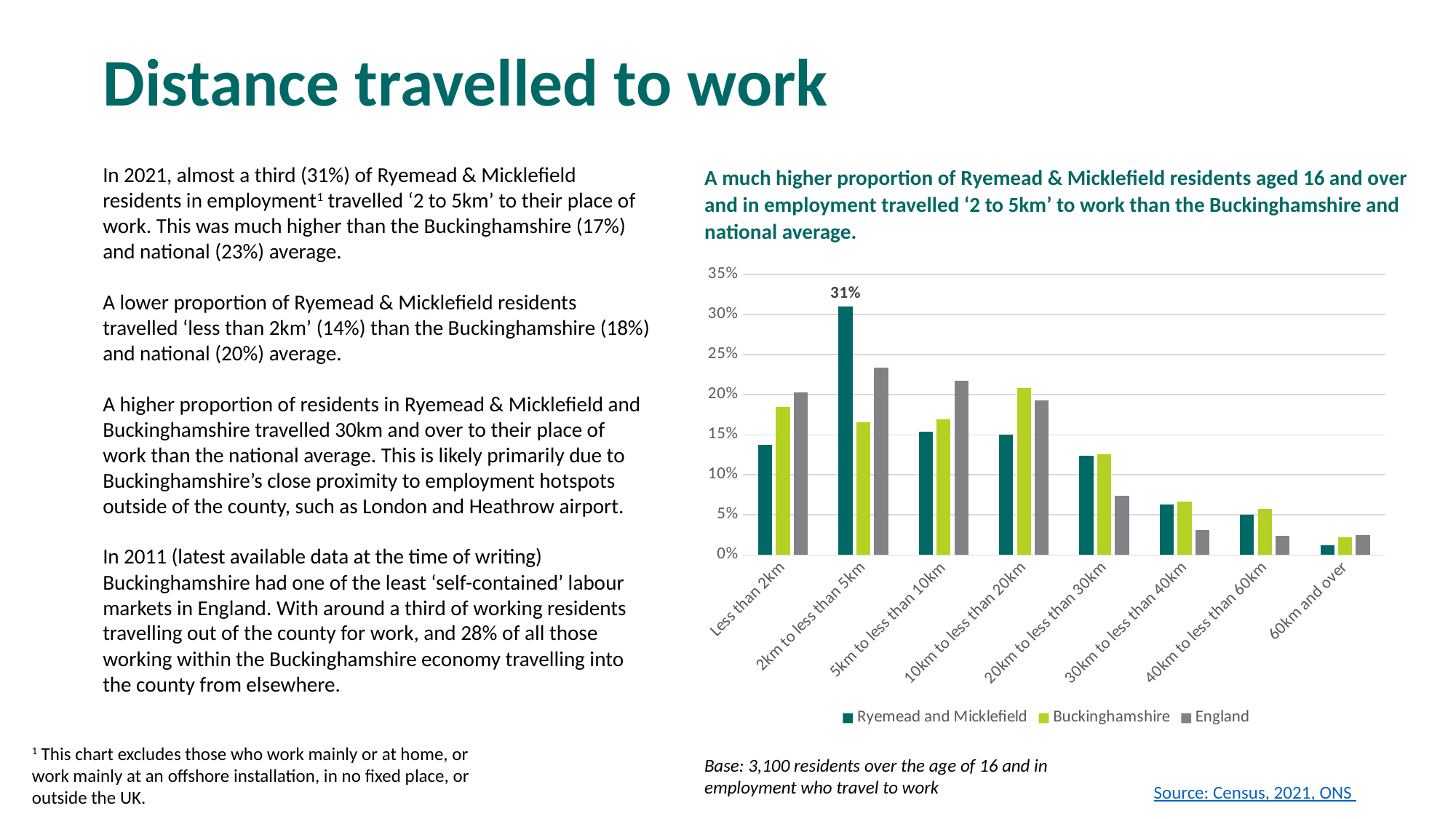
How many series does the chart's legend list? 3 Is the value for Buckinghamshire in the '2km to less than 5km' category greater or less than 20%? less In the '20km to less than 30km' category, which is larger: Ryemead and Micklefield or England? Ryemead and Micklefield Which distance category has the lowest value for Ryemead and Micklefield? 60km and over What is the value for Ryemead and Micklefield in the '2km to less than 5km' category? 31% Is the value for England in the 'Less than 2km' category greater or less than 15%? greater Which colour represents England in the chart's legend? Grey In the '10km to less than 20km' category, which is larger: Buckinghamshire or Ryemead and Micklefield? Buckinghamshire How many distance categories are shown on the x axis of the chart? 8 Which distance category has the highest value for Ryemead and Micklefield? 2km to less than 5km Is the value for England in the '30km to less than 40km' category greater or less than 5%? less What kind of chart is shown on the slide? Bar chart